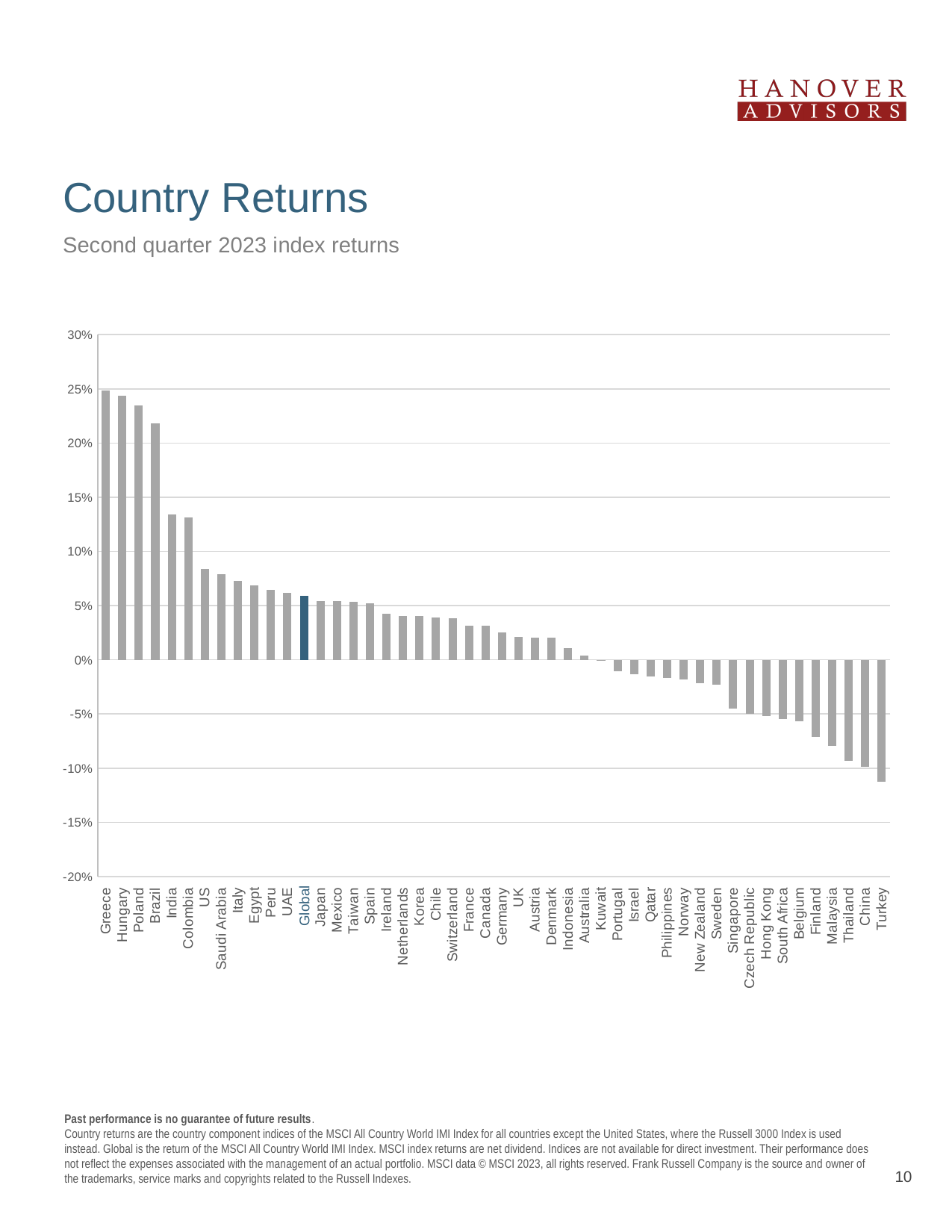
What kind of chart is shown on the slide? bar chart Is the value for Finland greater or less than -5%? less Is the value for Greece greater or less than 20%? greater Which country has the lowest second quarter 2023 index return? Turkey Is the value for Turkey greater or less than -10%? less Which has the larger return, Poland or Brazil? Poland Which has the larger return, Greece or Turkey? Greece Which country has the highest second quarter 2023 index return? Greece Do the values rise or fall moving from left to right along the x axis? fall Which bar is shown in a different colour (dark blue) from the others? Global